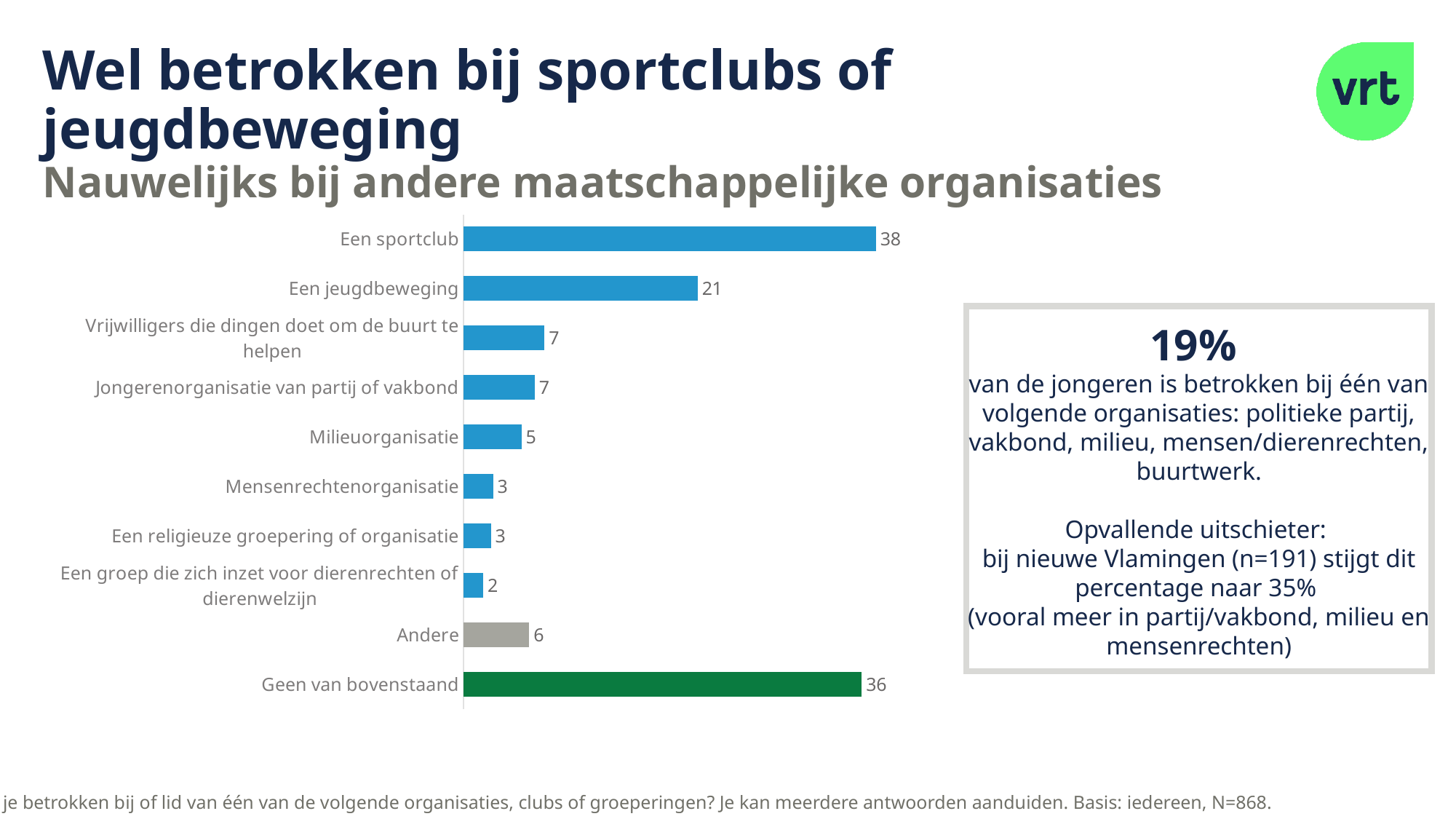
What is the difference between 'Geen van bovenstaand' and 'Andere'? 30 What colour is the bar for 'Geen van bovenstaand'? Green What is the value for 'Een sportclub'? 38 What is the difference between 'Een sportclub' and 'Een jeugdbeweging'? 17 What is the value for 'Een jeugdbeweging'? 21 Which category has the highest value? Een sportclub How many categories are shown in the chart? 10 Which category has the lowest value? Een groep die zich inzet voor dierenrechten of dierenwelzijn Which is larger: 'Andere' or 'Milieuorganisatie'? Andere What kind of chart is shown on the slide? Bar chart What is the value for 'Geen van bovenstaand'? 36 What is the value for 'Milieuorganisatie'? 5